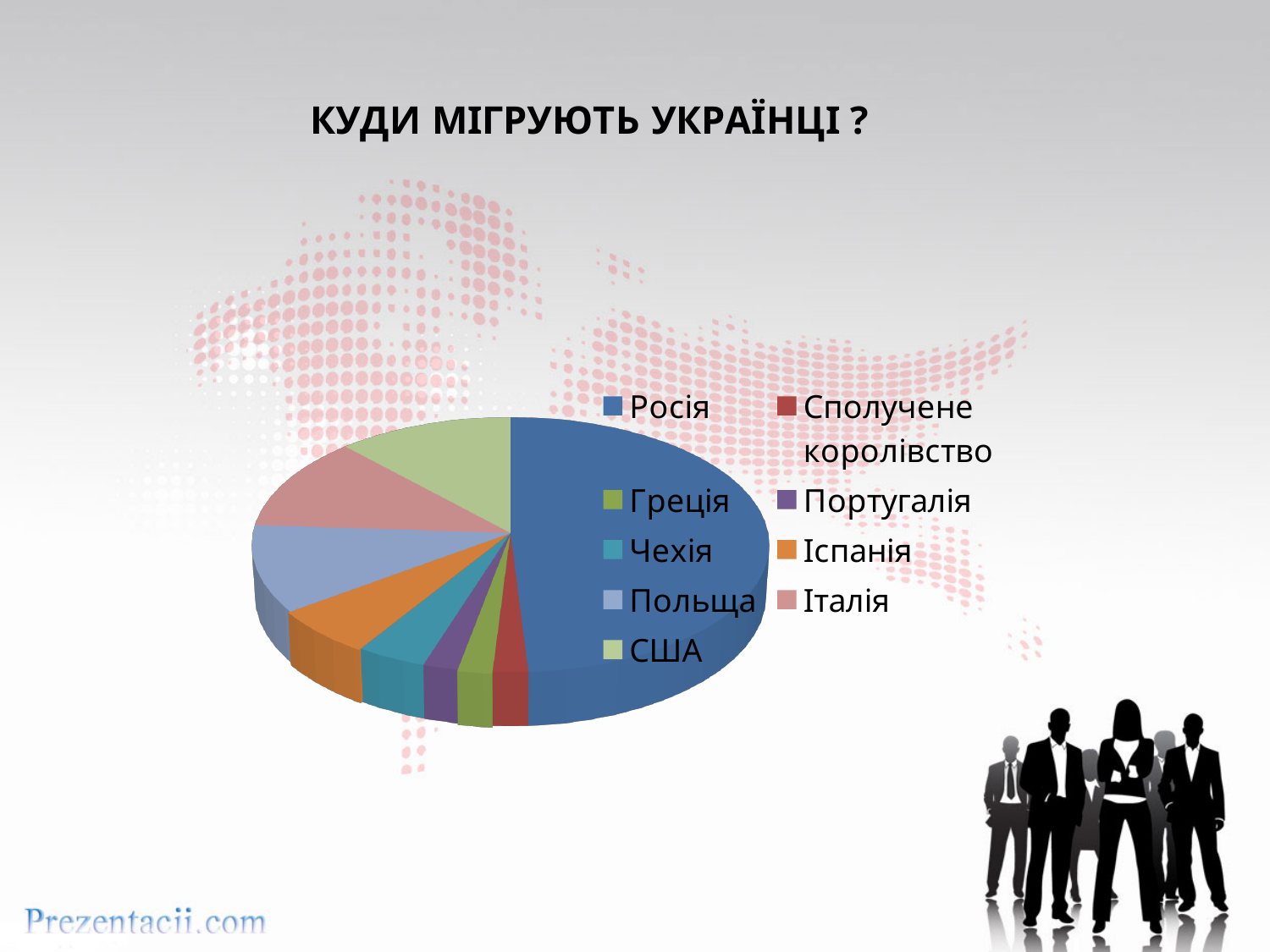
What is the title of the slide containing the pie chart? КУДИ МІГРУЮТЬ УКРАЇНЦІ ? Which country has the largest slice of the pie chart? Росія Which slice is larger, Польща or Греція? Польща Which slice is larger, США or Португалія? США Which slice is larger, Росія or Польща? Росія What colour is the slice for Росія in the pie chart? blue What kind of chart is shown on the slide? pie chart How many categories (countries) does the pie chart show? 9